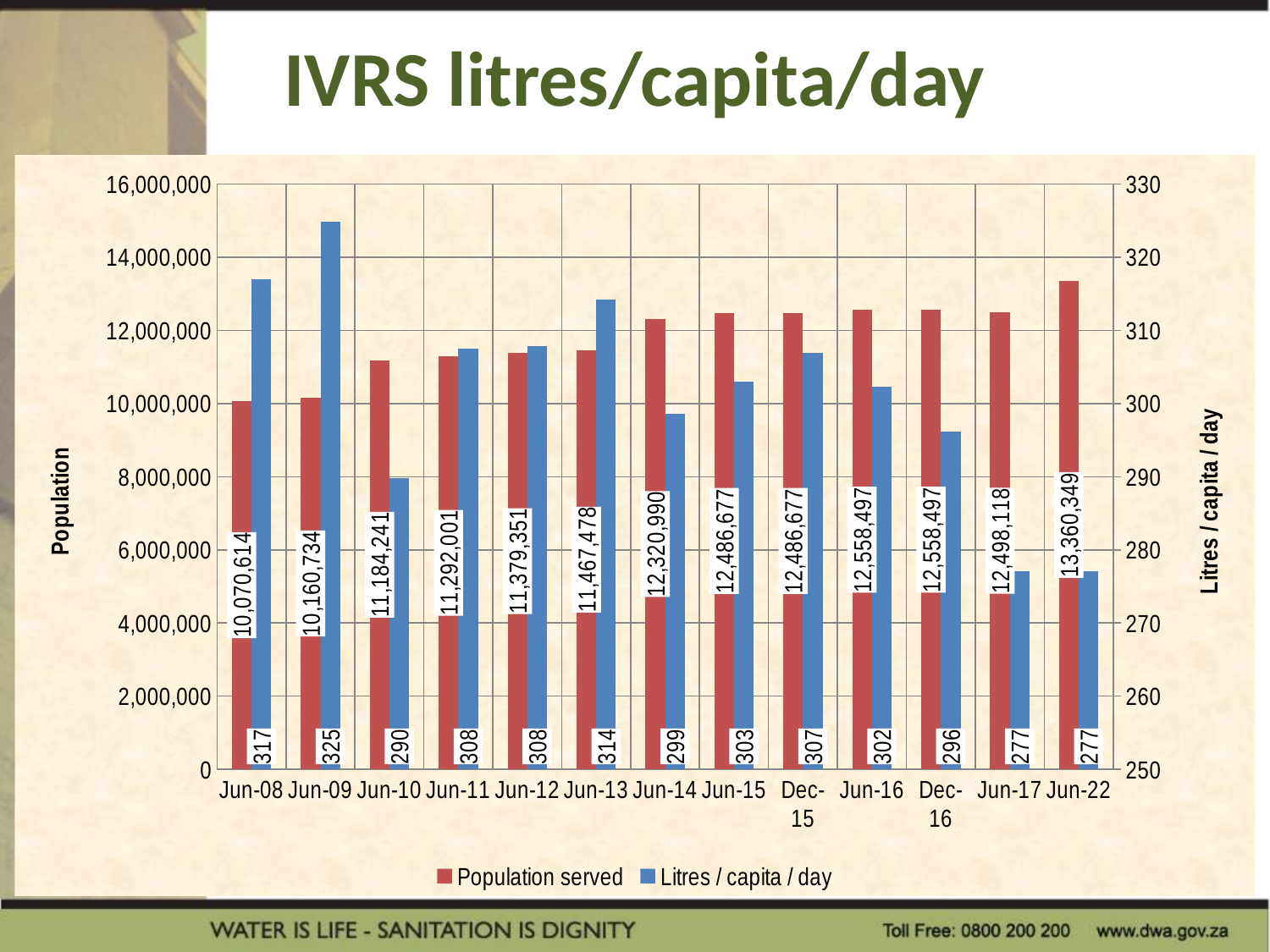
Is the Population served value for Jun-22 greater or less than 12,000,000? greater What is the Litres / capita / day value for Jun-14? 299 What is the Population served value for Jun-22? 13,360,349 Which period has the lowest Population served value? Jun-08 How many series does the legend list? 2 What kind of chart is shown on the slide? Bar chart What is the Litres / capita / day value for Jun-09? 325 How many periods are shown on the x axis? 13 Which is larger, the Population served in Jun-14 or in Jun-13? Jun-14 What is the label of the right-hand vertical axis? Litres / capita / day What is the difference in Litres / capita / day between Jun-08 and Jun-10? 27 Which period has the highest Litres / capita / day value? Jun-09